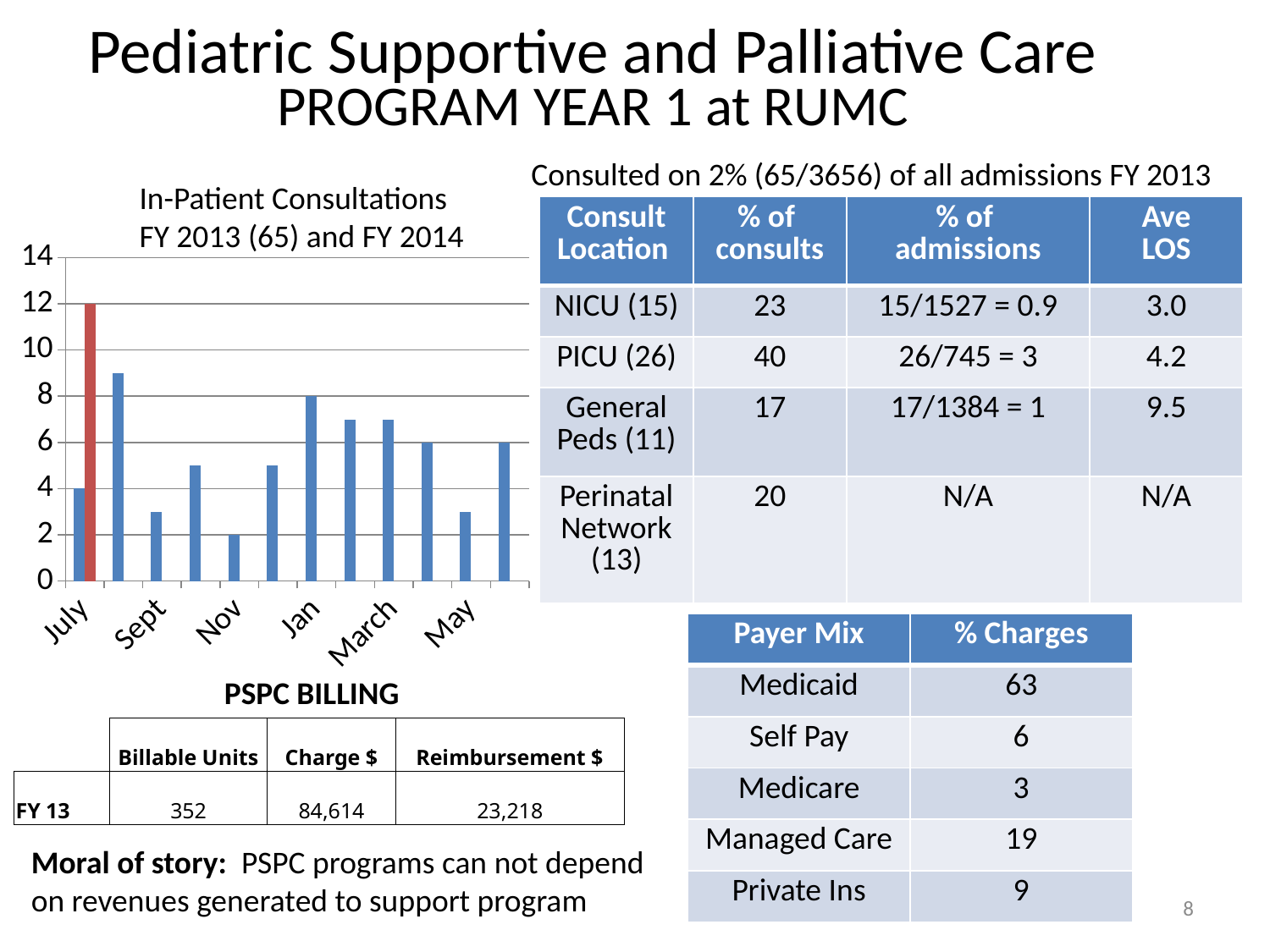
What value does the red bar for July reach on the chart? 12 What value does the bar for Jan reach on the chart? 8 Which bar is the tallest on the chart? the red bar for July Which month has the lowest bar on the chart? Nov Which is larger, the bar for Jan or the bar for May? Jan What value does the bar for Nov reach on the chart? 2 What is the difference between the bar for Jan and the bar for Nov? 6 What kind of chart is shown on the slide? bar chart Is the value for March greater or less than 6? greater How many bars are plotted on the chart? 13 Is the value for Sept greater or less than 4? less What is the title of the chart on the slide? In-Patient Consultations FY 2013 (65) and FY 2014